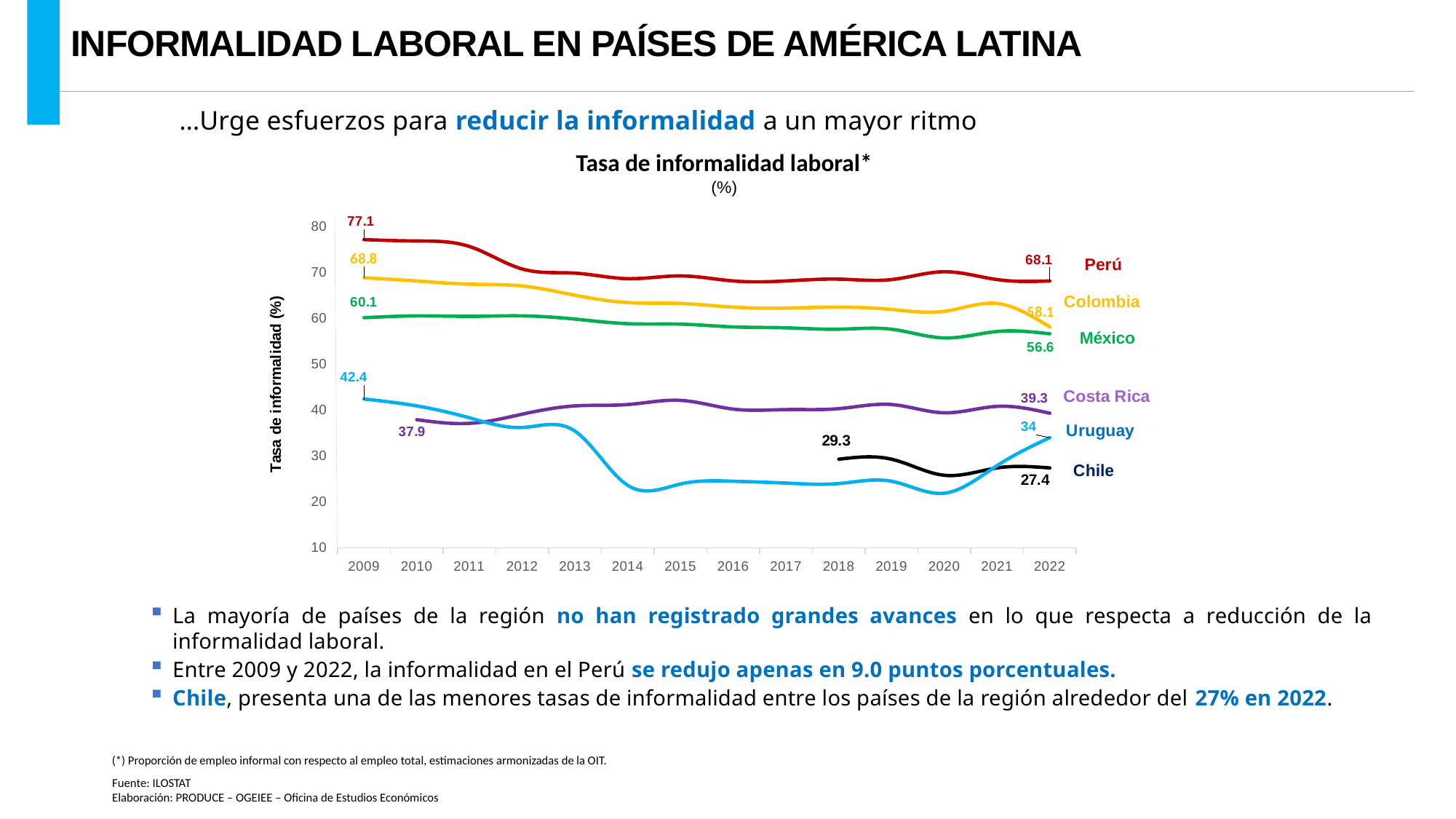
Which country had the lowest labor informality rate in 2022? Chile What is the difference between Colombia's rate in 2009 and in 2022? 10.7 What was Chile's labor informality rate in 2018? 29.3 What was Colombia's labor informality rate in 2022? 58.1 Did Costa Rica's informality rate rise or fall between 2010 and 2022? rise Which country had the highest labor informality rate in 2022? Perú How many countries are plotted in the chart? 6 What was Peru's labor informality rate in 2009? 77.1 What was Peru's labor informality rate in 2022? 68.1 What type of chart is shown on the slide? line chart By how many points did Peru's informality rate fall between 2009 and 2022? 9.0 What was Uruguay's labor informality rate in 2009? 42.4